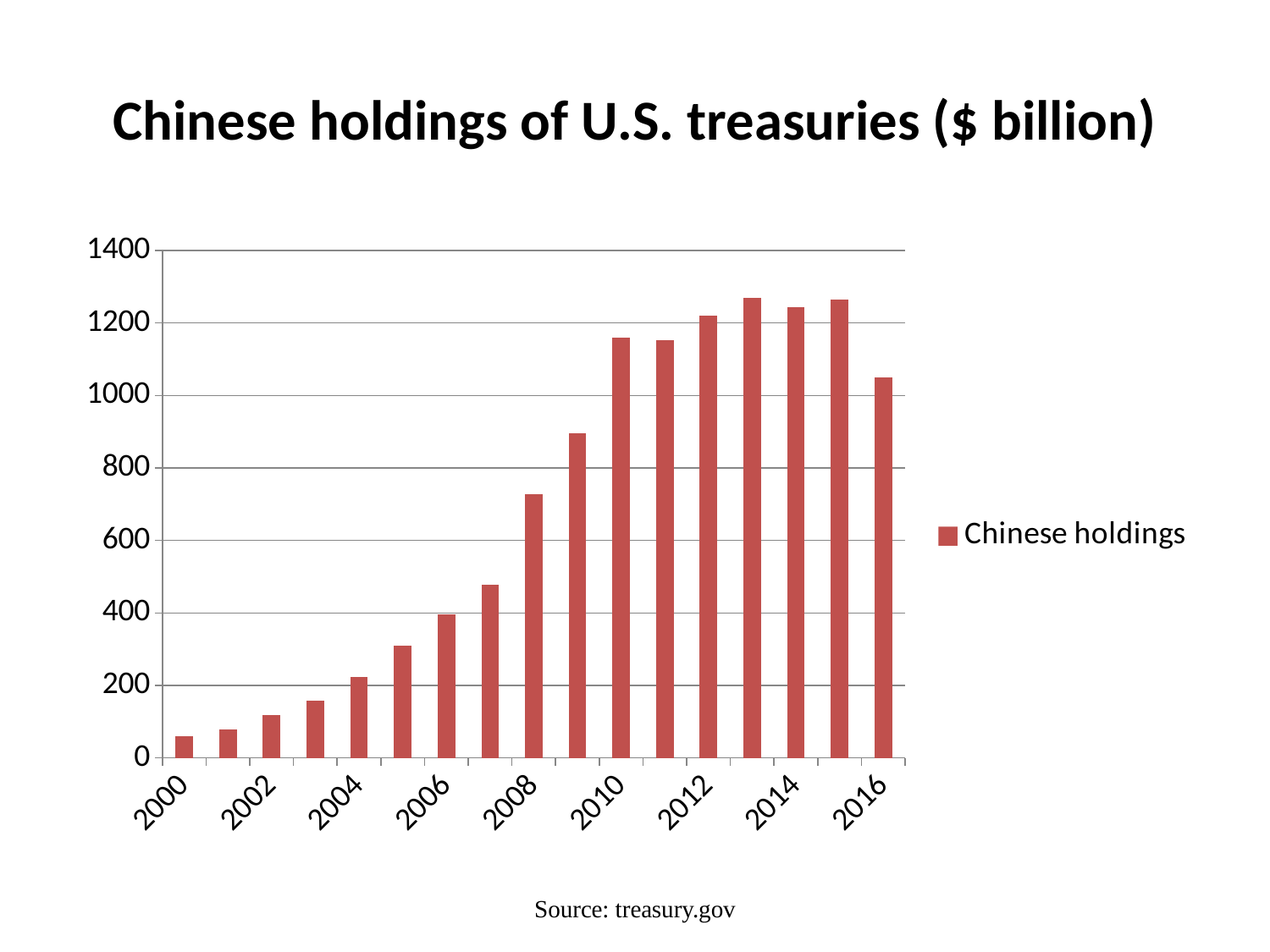
Is the value for 2003 greater or less than 200? less Is the value for 2016 greater or less than 1000? greater Is the value for 2009 greater or less than 800? greater Do the values generally rise or fall from 2000 to 2010? rise Which year has the larger value, 2015 or 2016? 2015 What is the name of the series shown in the legend? Chinese holdings Which year has the larger value, 2008 or 2009? 2009 How many years (bars) are plotted in the chart? 17 How many series does the legend list? 1 What kind of chart is shown on the slide? bar chart Which year has the lowest value of Chinese holdings? 2000